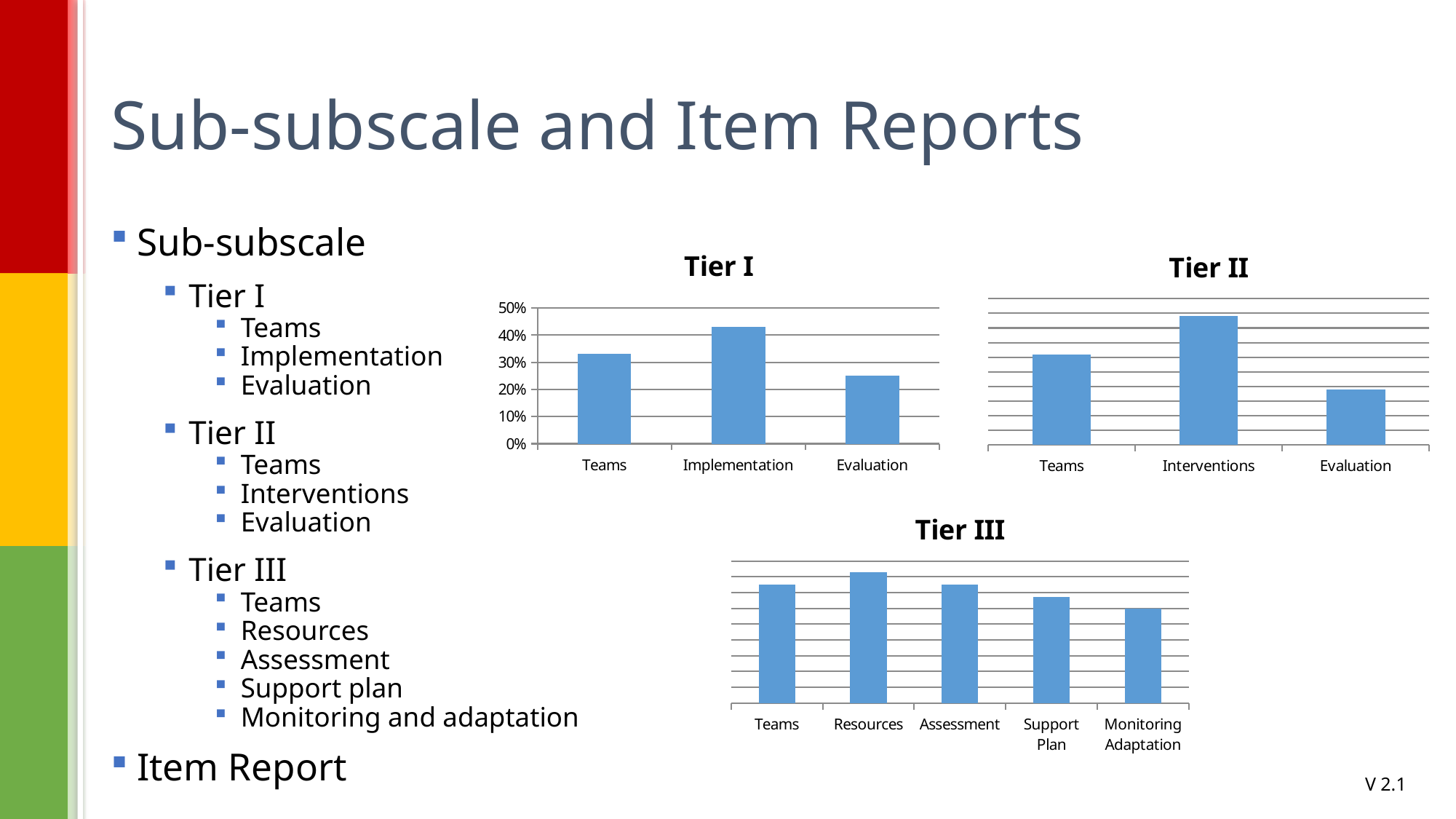
What type of chart is the Tier I chart? Bar chart In the Tier I chart, is the value for Implementation greater or less than 40%? greater In the Tier I chart, is the value for Teams greater or less than 30%? greater In the Tier I chart, which category has the lowest value? Evaluation In the Tier I chart, is the value for Evaluation greater or less than 30%? less In the Tier III chart, which category has the highest value? Resources In the Tier III chart, which category has the lowest value? Monitoring Adaptation In the Tier II chart, which category has the highest value? Interventions In the Tier I chart, which category has the highest value? Implementation How many categories are shown in the Tier III chart? 5 In the Tier II chart, which category has the lowest value? Evaluation In the Tier II chart, which is larger, Teams or Evaluation? Teams